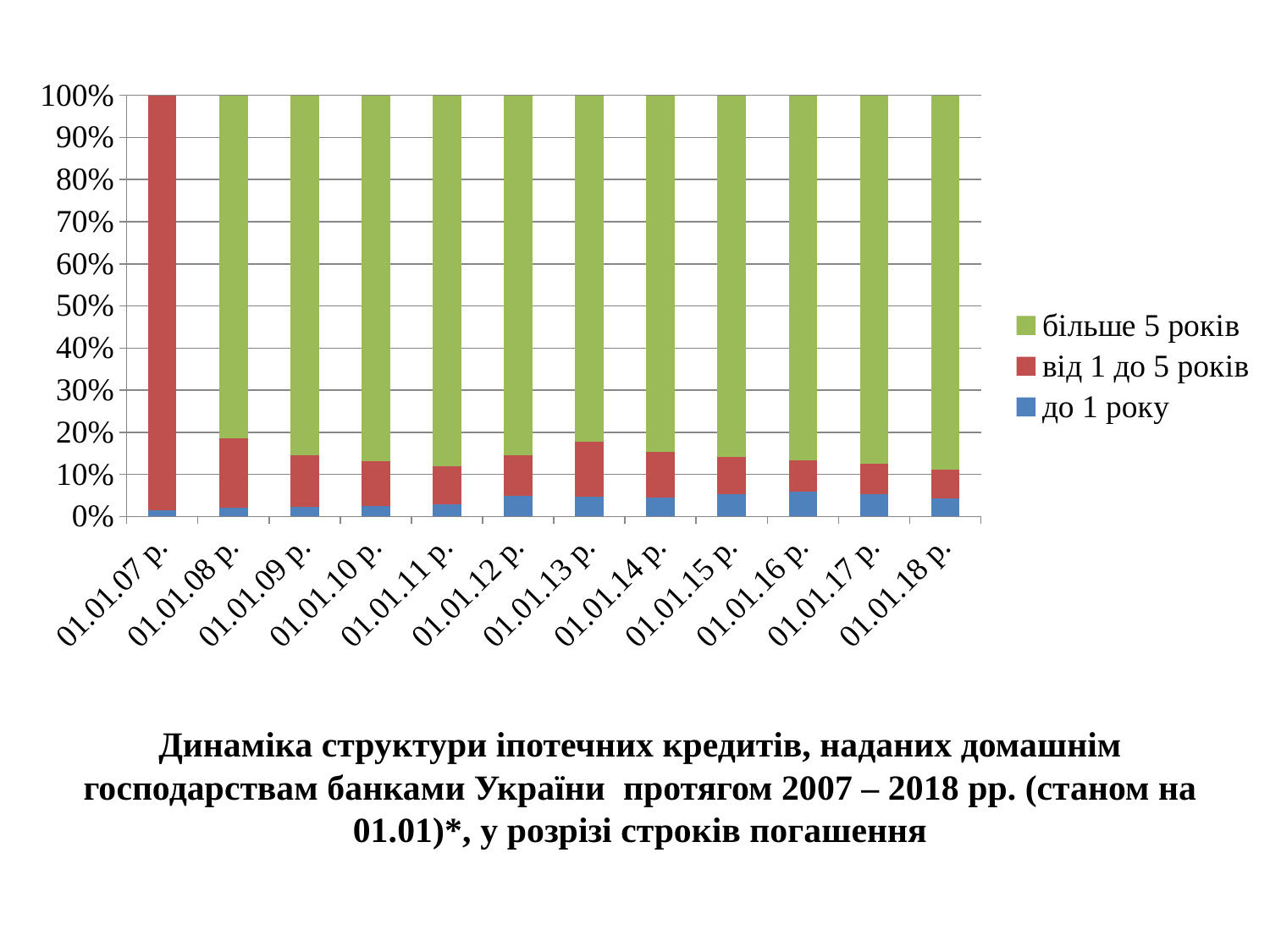
Which date has the largest share for 'від 1 до 5 років'? 01.01.07 р. Does the 'до 1 року' share rise or fall from 01.01.07 р. to 01.01.15 р.? rise What is the total height of the stacked bar for 01.01.12 р.? 100% Is the value for 'до 1 року' at 01.01.16 р. greater or less than 10%? less How many dates (categories) are shown along the x axis? 12 Is the value for 'від 1 до 5 років' at 01.01.07 р. greater or less than 90%? greater Which is larger: the 'до 1 року' share at 01.01.07 р. or at 01.01.16 р.? 01.01.16 р. How many series does the legend list? 3 Which date has the smallest share for 'більше 5 років'? 01.01.07 р. What kind of chart is shown on the slide? stacked bar chart Which series is shown in green in the legend? більше 5 років Is the value for 'більше 5 років' at 01.01.08 р. greater or less than 70%? greater